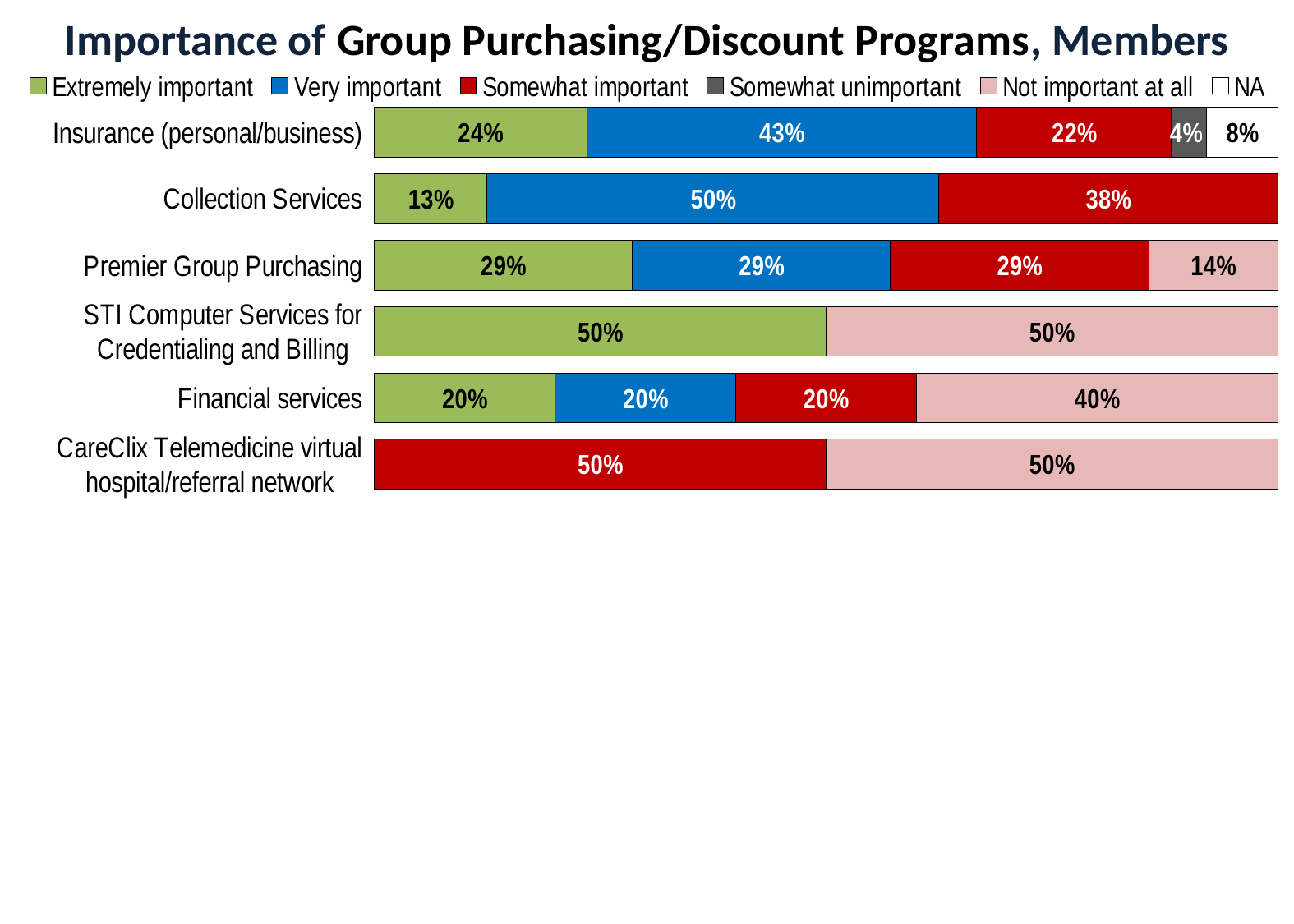
What is the combined percentage of Extremely important and Very important for Insurance (personal/business)? 67% What percentage of members rated Insurance (personal/business) as Very important? 43% Which category has the highest Extremely important percentage? STI Computer Services for Credentialing and Billing What percentage of members rated Financial services as Not important at all? 40% What kind of chart is shown on the slide? Stacked bar chart What is the difference between the Very important percentages for Collection Services and Premier Group Purchasing? 21% How many categories are shown in the chart? 6 What percentage of members rated STI Computer Services for Credentialing and Billing as Extremely important? 50% What percentage of members rated Collection Services as Somewhat important? 38% Which category has the lowest Extremely important percentage among those with an Extremely important segment? Collection Services How many series does the legend list? 6 Which is larger: the Somewhat important percentage for Collection Services or for Insurance (personal/business)? Collection Services